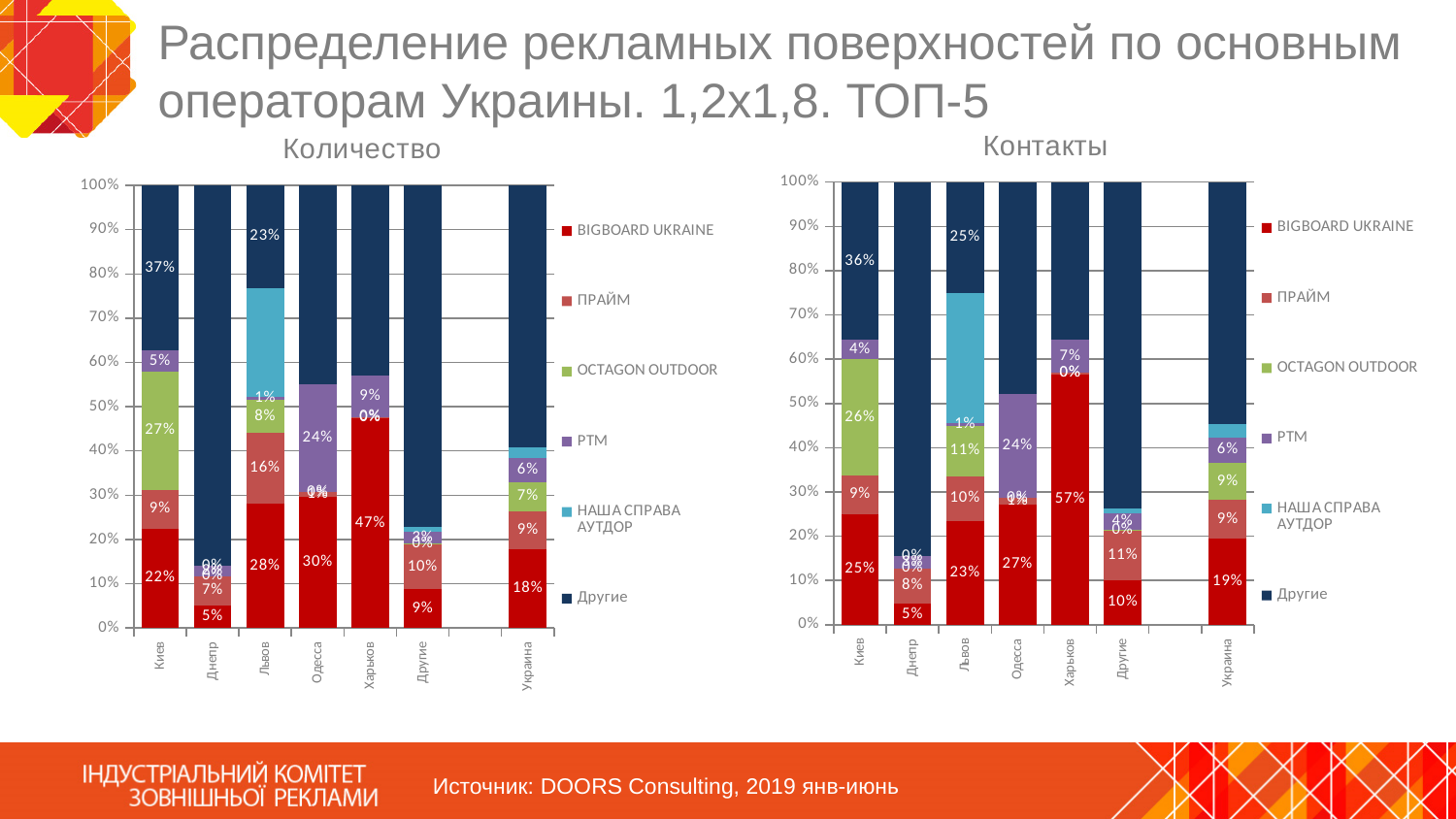
In the "Количество" chart, which category has the highest BIGBOARD UKRAINE value? Харьков In the "Количество" chart, what is the OCTAGON OUTDOOR value for Киев? 27% In the "Количество" chart, which is larger: the BIGBOARD UKRAINE value for Львов or for Одесса? Одесса In the "Контакты" chart, what is the BIGBOARD UKRAINE value for Харьков? 57% In the "Контакты" chart, what is the Другие (series) value for Киев? 36% How many categories are shown on the x axis of the "Контакты" chart? 7 In the "Контакты" chart, what is the РТМ value for Одесса? 24% In the "Контакты" chart, which category has the lowest BIGBOARD UKRAINE value? Днепр In the "Количество" chart, what is the BIGBOARD UKRAINE value for Харьков? 47% In the "Количество" chart, what is the BIGBOARD UKRAINE value for Киев? 22% In the "Контакты" chart, what is the difference between the BIGBOARD UKRAINE values for Харьков and Киев? 32% How many series does the legend of the "Количество" chart list? 6